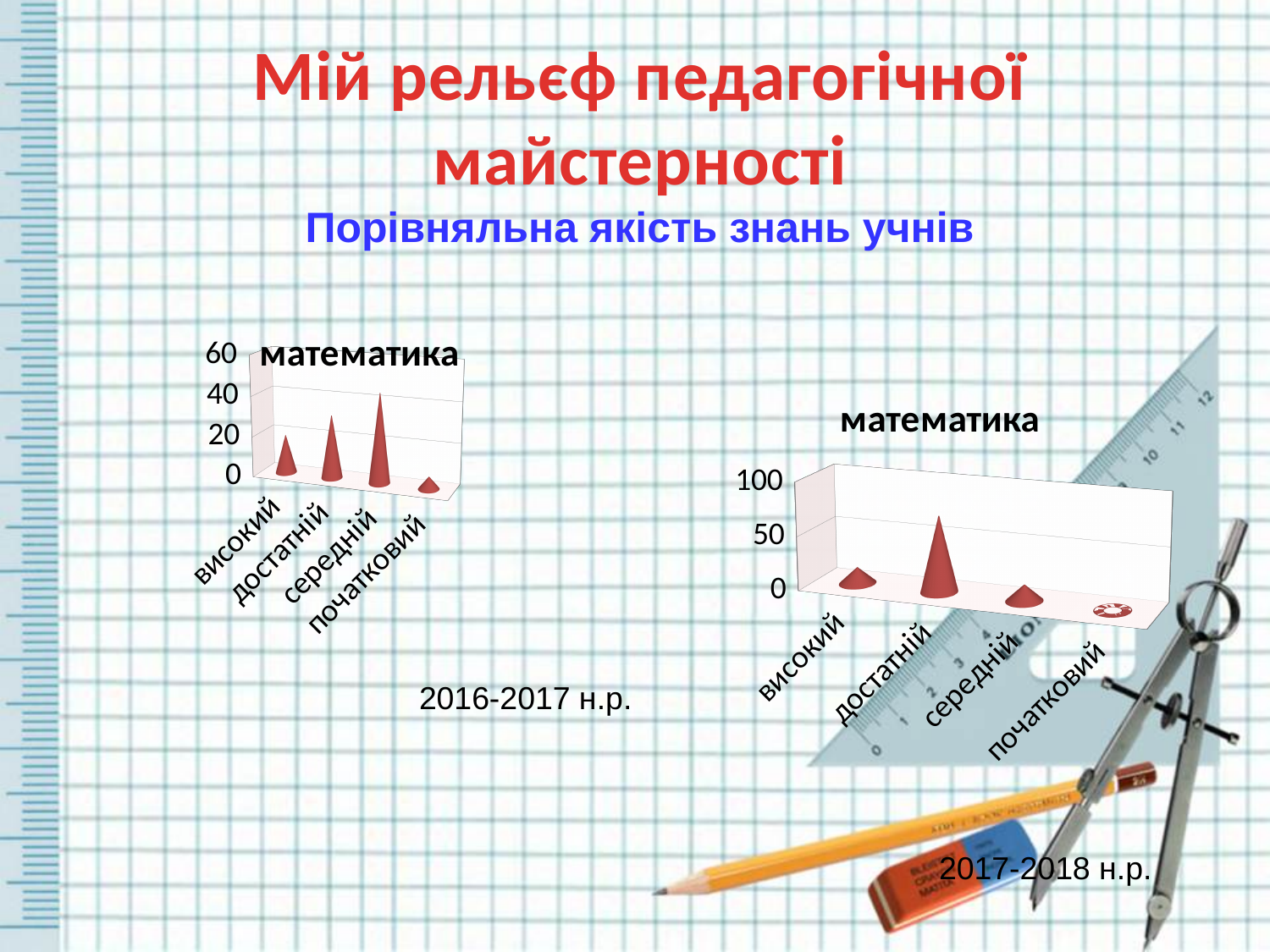
In the right chart (2017-2018 н.р.), is the value for достатній greater or less than 50? greater In the right chart (2017-2018 н.р.), which is larger, the value for достатній or the value for середній? достатній What is the title of the right chart (2017-2018 н.р.)? математика In the right chart (2017-2018 н.р.), is the value for високий greater or less than 50? less In the left chart (2016-2017 н.р.), is the value for початковий greater or less than 20? less In the left chart (2016-2017 н.р.), which category has the highest value? середній In the left chart (2016-2017 н.р.), which category has the lowest value? початковий In the right chart (2017-2018 н.р.), which category has the lowest value? початковий In the left chart (2016-2017 н.р.), which is larger, the value for достатній or the value for високий? достатній In the right chart (2017-2018 н.р.), which category has the highest value? достатній How many categories are shown on the x axis of the left chart (2016-2017 н.р.)? 4